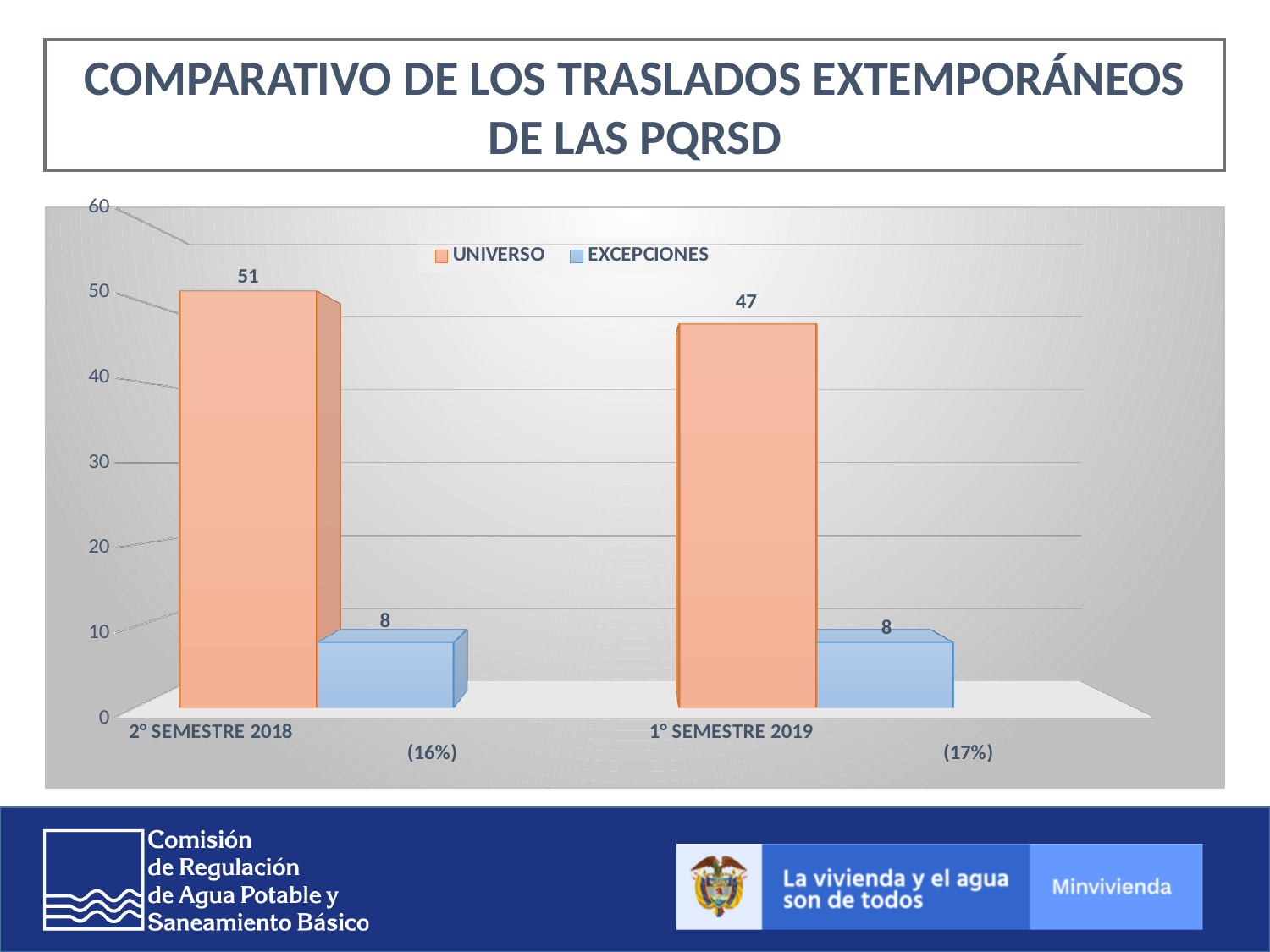
What is the UNIVERSO value for 2° SEMESTRE 2018? 51 How many periods are shown on the x axis? 2 What percentage is shown below the 1° SEMESTRE 2019 bars? (17%) What is the EXCEPCIONES value for 2° SEMESTRE 2018? 8 Is the UNIVERSO value for 1° SEMESTRE 2019 greater or less than 50? less What is the difference between the UNIVERSO values for 2° SEMESTRE 2018 and 1° SEMESTRE 2019? 4 How many series does the legend list? 2 What kind of chart is shown on the slide? bar chart What is the UNIVERSO value for 1° SEMESTRE 2019? 47 Which period has the higher UNIVERSO value? 2° SEMESTRE 2018 Does the UNIVERSO value rise or fall from 2° SEMESTRE 2018 to 1° SEMESTRE 2019? fall What is the EXCEPCIONES value for 1° SEMESTRE 2019? 8